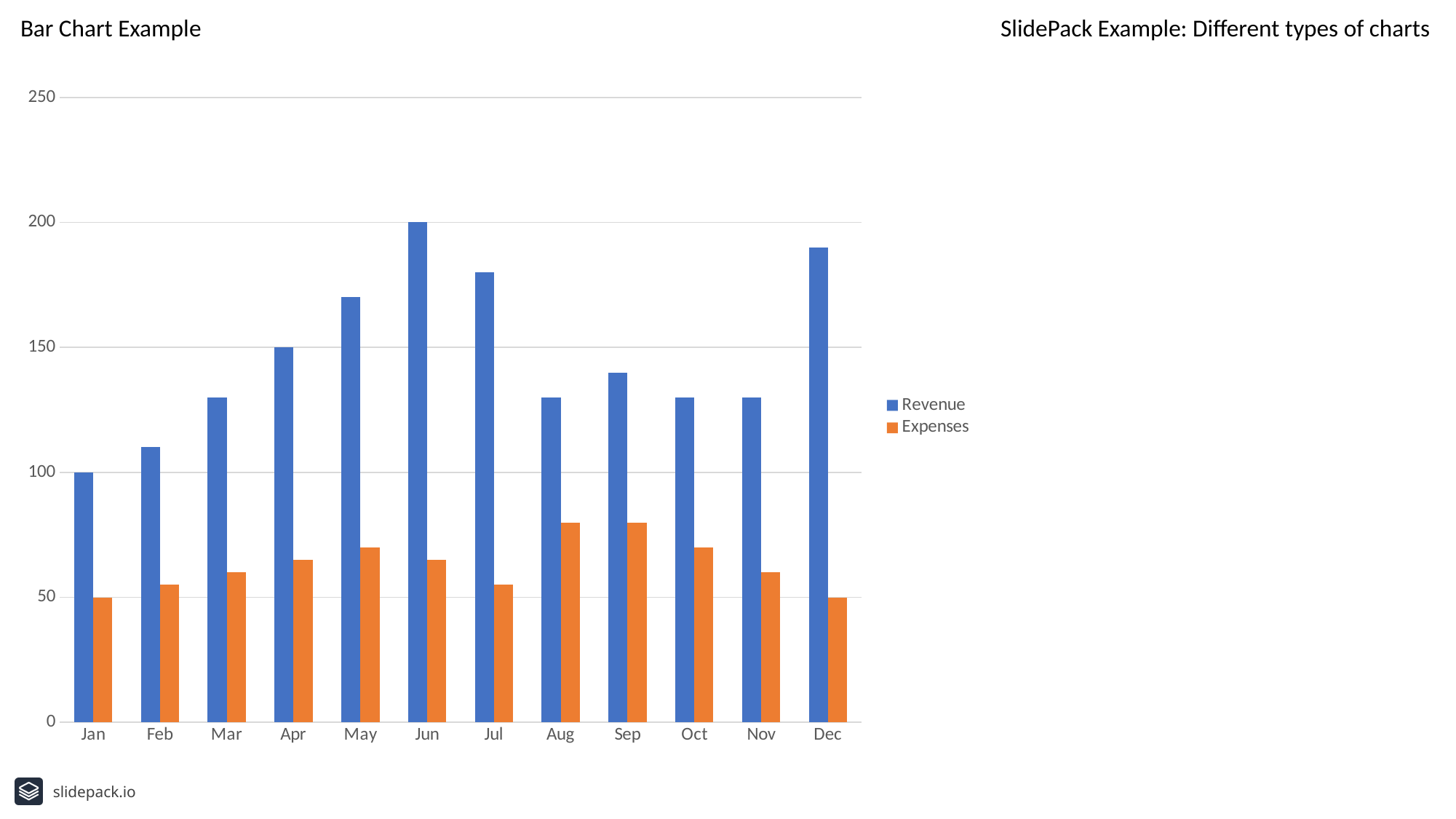
Is the Expenses value for Aug greater or less than 50? greater How many series does the legend list? 2 What is the Revenue value for Jan? 100 Does Revenue rise or fall from Jan to Jun? rise What is the Expenses value for Jan? 50 Which month has the highest Revenue? Jun Is the Revenue value for Dec greater or less than 150? greater What is the difference between the Revenue for Jun and the Revenue for Jan? 100 What is the Revenue value for Jun? 200 What type of chart is shown on the slide? bar chart How many months are shown on the x axis? 12 Which month has the lowest Revenue? Jan